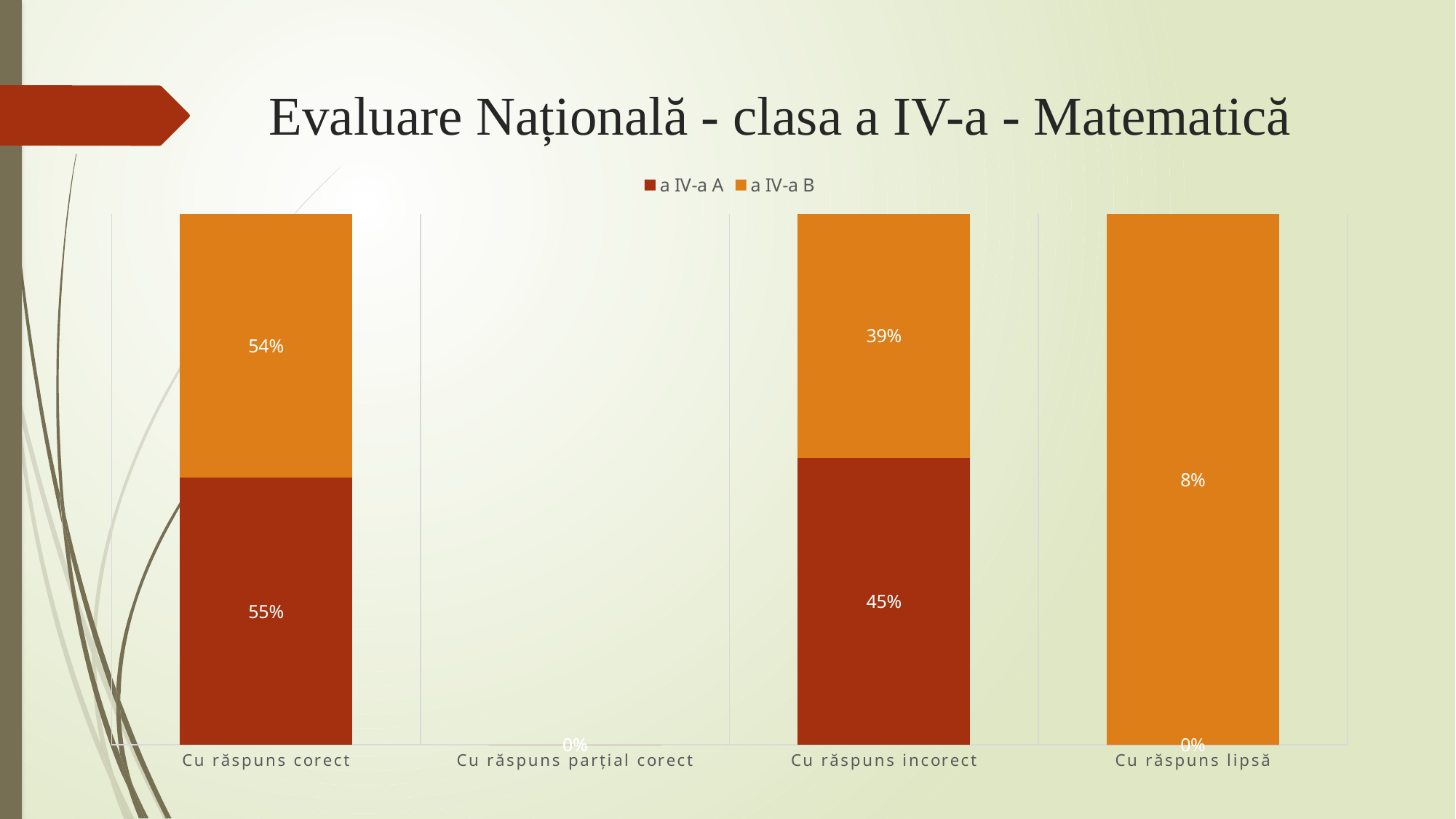
In which category does a IV-a B have its highest value? Cu răspuns corect What is the value for a IV-a B in the 'Cu răspuns lipsă' category? 8% What is the value for a IV-a A in the 'Cu răspuns incorect' category? 45% How many categories are shown on the x axis? 4 What is the value for a IV-a A in the 'Cu răspuns lipsă' category? 0% What kind of chart is shown on the slide? bar chart What is the value for a IV-a B in the 'Cu răspuns corect' category? 54% How many series does the legend list? 2 What is the value for a IV-a A in the 'Cu răspuns corect' category? 55% What is the value for a IV-a B in the 'Cu răspuns incorect' category? 39% What is the title of the chart? Evaluare Națională - clasa a IV-a - Matematică What is the difference between a IV-a A and a IV-a B in the 'Cu răspuns incorect' category? 6 percentage points